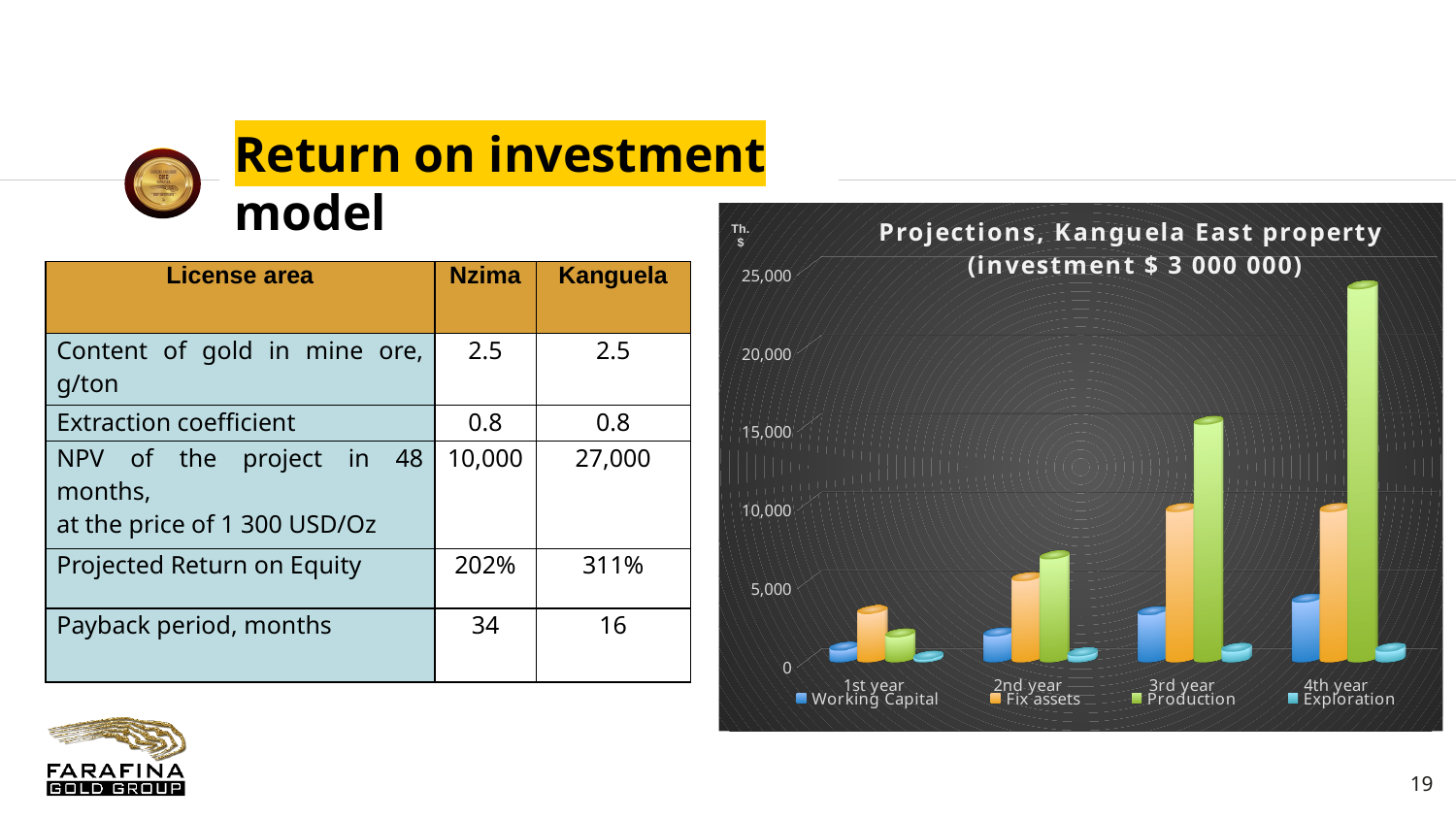
Is the Production value for the 4th year greater or less than 20,000? greater How many year categories are shown on the x axis of the chart? 4 In which year is the Production bar the highest? 4th year Is the Fix assets value for the 1st year greater or less than 5,000? less Is the Production value for the 2nd year greater or less than 5,000? greater What is the title of the chart? Projections, Kanguela East property (investment $ 3 000 000) Which is larger, the Production value in the 3rd year or in the 4th year? 4th year Which series has the tallest bar in the 4th year? Production How many series does the chart legend list? 4 What kind of chart is shown on the slide? bar chart Which series has the smallest bar in the 3rd year? Exploration Do the Production values rise or fall from the 1st year to the 4th year? rise